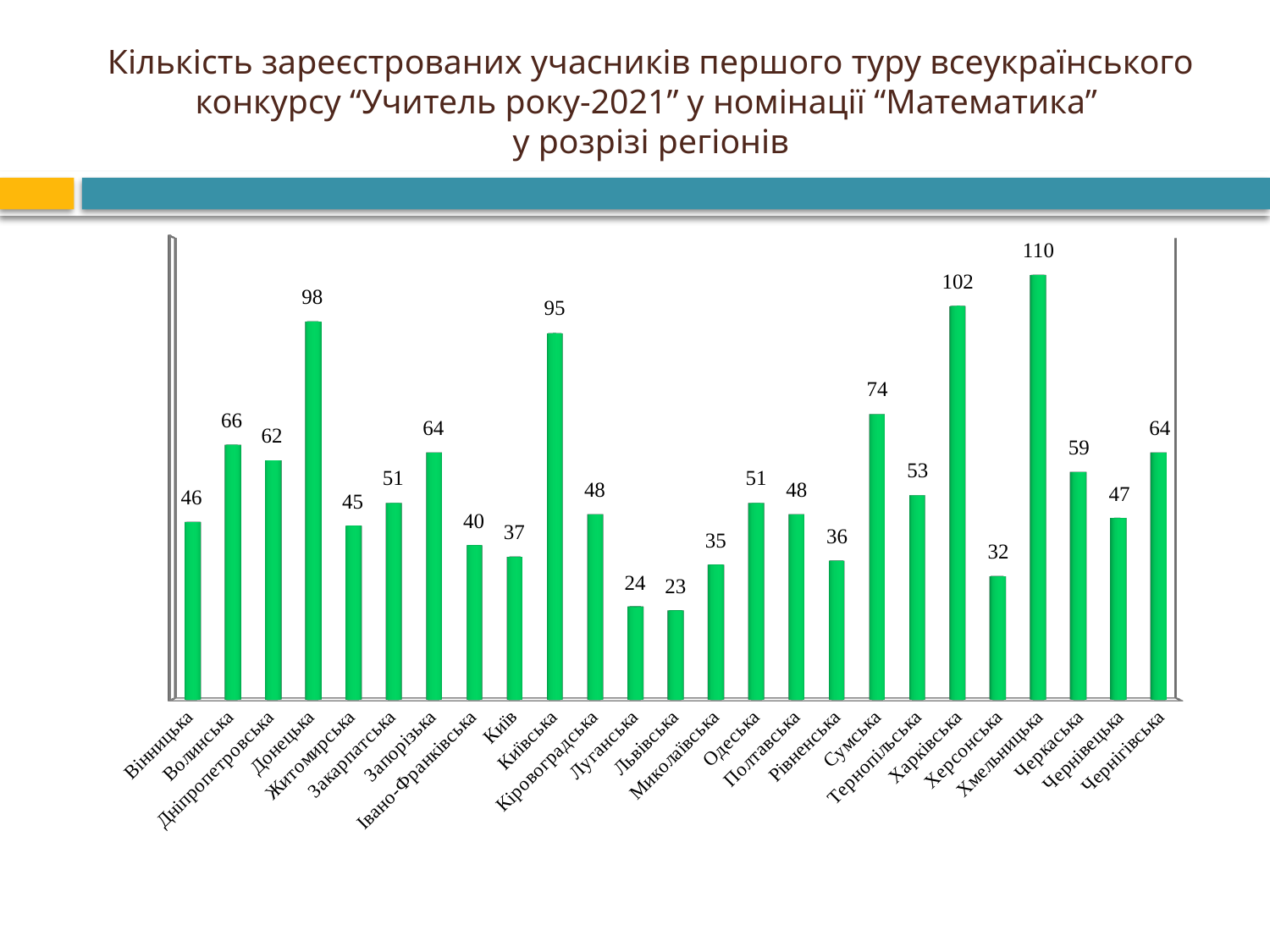
What is the value for Чернігівська? 64 Which is larger, the value for Херсонська or the value for Рівненська? Рівненська Which region has the lowest value? Львівська What is the value for Донецька? 98 What is the difference between the values for Харківська and Сумська? 28 Which region has the highest value? Хмельницька How many regions are shown on the chart? 25 What kind of chart is shown on the slide? Bar chart What is the value for Київ? 37 What is the difference between the values for Київська and Київ? 58 Which is larger, the value for Волинська or the value for Дніпропетровська? Волинська What is the value for Хмельницька? 110